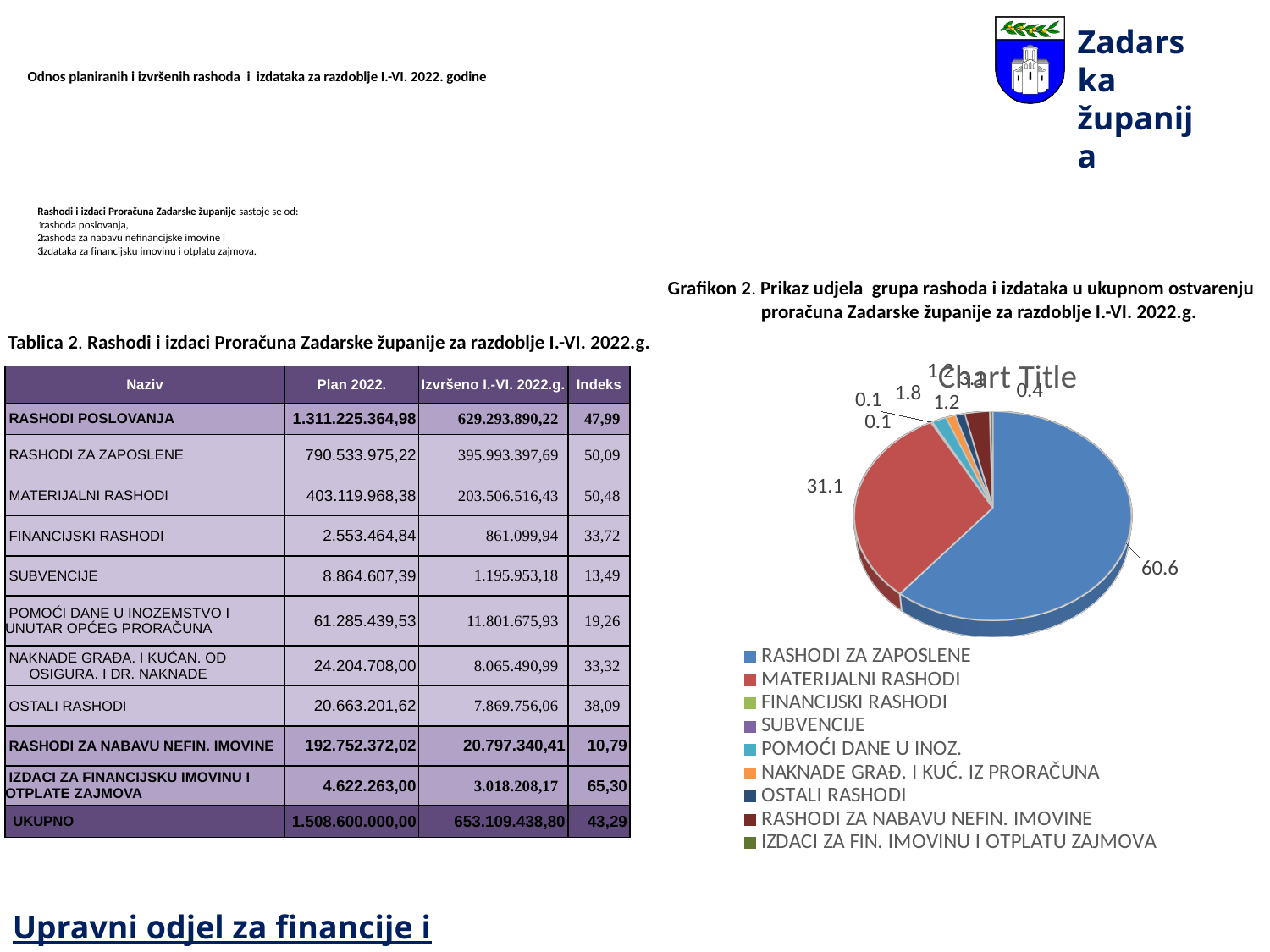
What colour is the largest slice of the pie chart? blue What type of chart is shown on the slide? pie chart Which is larger in the pie chart, RASHODI ZA ZAPOSLENE or MATERIJALNI RASHODI? RASHODI ZA ZAPOSLENE How many categories does the legend of the pie chart list? 9 What is the value shown for RASHODI ZA ZAPOSLENE in the pie chart? 60.6 What is the title displayed above the pie chart? Chart Title Is the value for MATERIJALNI RASHODI in the pie chart greater or less than 40? less What is the difference between the values for RASHODI ZA ZAPOSLENE and MATERIJALNI RASHODI in the pie chart? 29.5 Which category has the largest slice in the pie chart? RASHODI ZA ZAPOSLENE What is the value shown for MATERIJALNI RASHODI in the pie chart? 31.1 Is the value for RASHODI ZA ZAPOSLENE in the pie chart greater or less than 50? greater